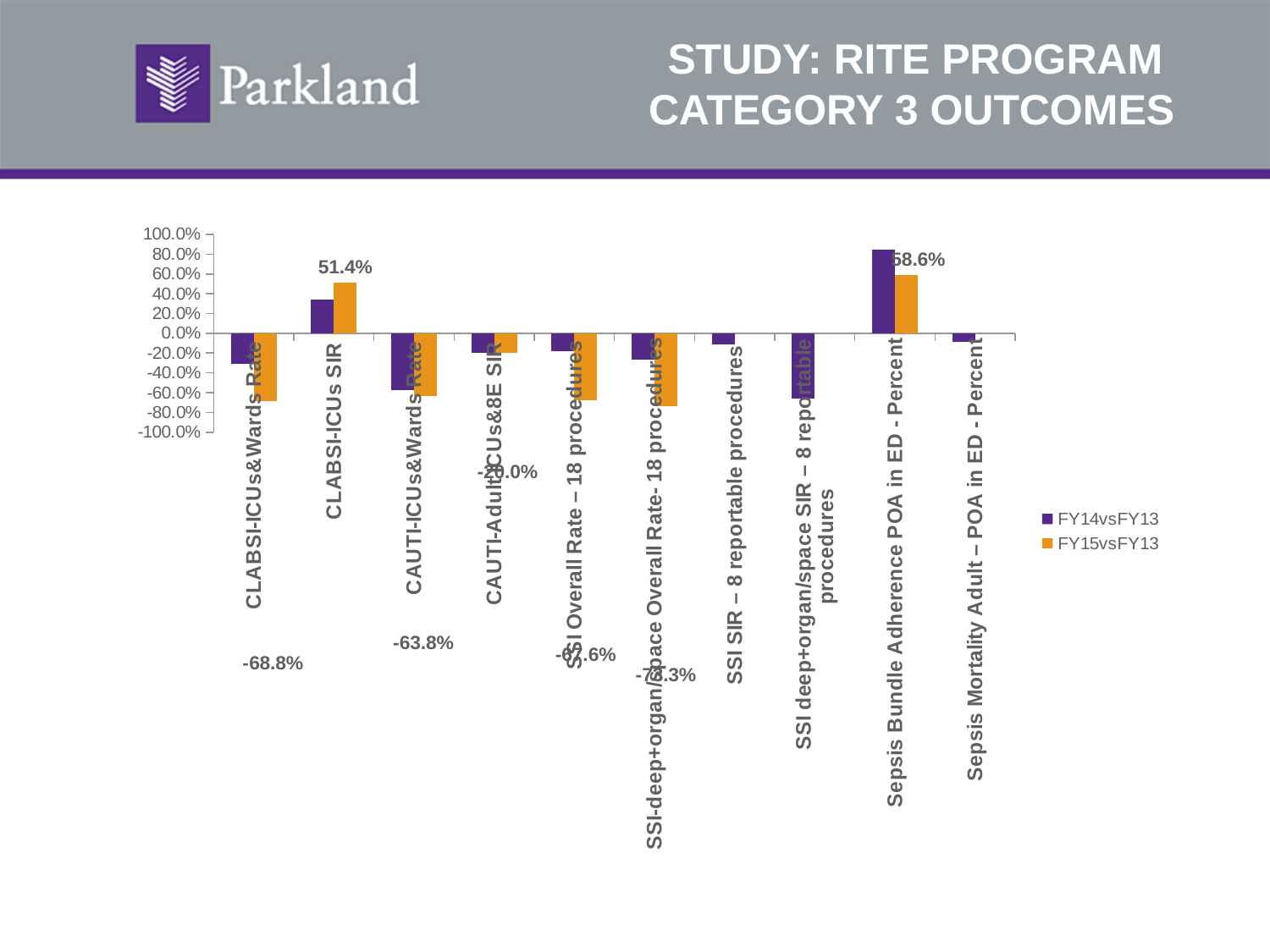
How many series does the legend list? 2 Which category has the highest FY14vsFY13 value? Sepsis Bundle Adherence POA in ED - Percent What is the FY15vsFY13 value for CAUTI-Adult ICUs&8E SIR? -20.0% How many categories are shown on the x axis? 10 Is the FY14vsFY13 value for Sepsis Bundle Adherence POA in ED - Percent greater or less than 60.0%? greater What is the FY15vsFY13 value for CAUTI-ICUs&Wards Rate? -63.8% What is the FY15vsFY13 value for CLABSI-ICUs&Wards Rate? -68.8% For CLABSI-ICUs SIR, which series has the larger value, FY14vsFY13 or FY15vsFY13? FY15vsFY13 What is the FY15vsFY13 value for CLABSI-ICUs SIR? 51.4% What is the FY15vsFY13 value for Sepsis Bundle Adherence POA in ED - Percent? 58.6% What kind of chart is shown on the slide? Bar chart What are the two series named in the legend? FY14vsFY13 and FY15vsFY13